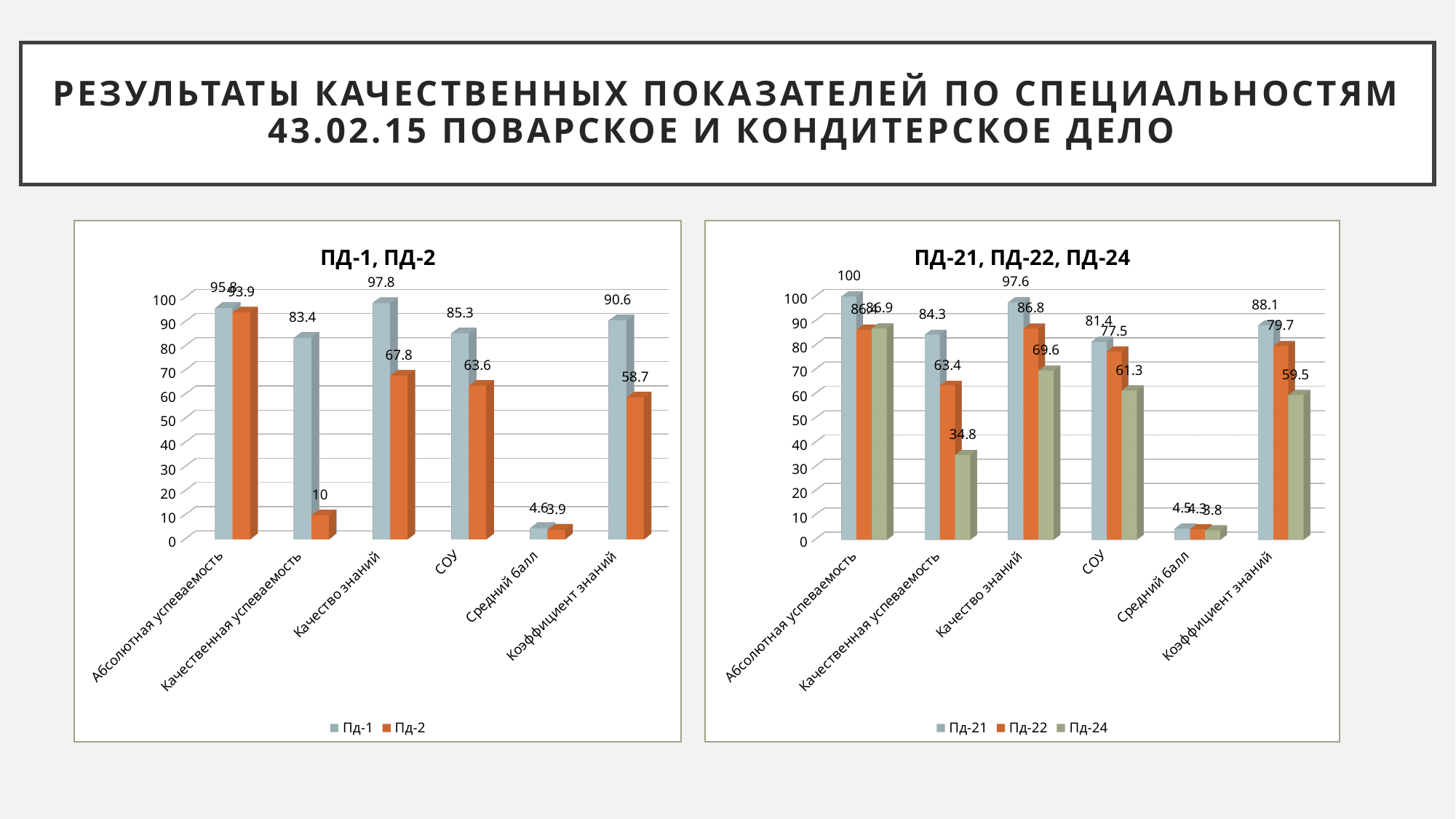
In the chart titled ПД-21, ПД-22, ПД-24, which is larger for Коэффициент знаний: Пд-22 or Пд-24? Пд-22 In the chart titled ПД-21, ПД-22, ПД-24, what is the value of Пд-22 for СОУ? 77.5 In the chart titled ПД-1, ПД-2, what is the value of Пд-2 for Качественная успеваемость? 10 In the chart titled ПД-1, ПД-2, what is the difference between Пд-1 and Пд-2 for Коэффициент знаний? 31.9 In the chart titled ПД-21, ПД-22, ПД-24, what is the value of Пд-24 for Качественная успеваемость? 34.8 In the chart titled ПД-21, ПД-22, ПД-24, what is the difference between Пд-21 and Пд-22 for Качество знаний? 10.8 In the chart titled ПД-1, ПД-2, which category has the highest Пд-1 value? Качество знаний How many categories are shown on the x axis of the chart titled ПД-21, ПД-22, ПД-24? 6 In the chart titled ПД-1, ПД-2, what is the value of Пд-1 for Качество знаний? 97.8 In the chart titled ПД-1, ПД-2, how many series does the legend list? 2 In the chart titled ПД-21, ПД-22, ПД-24, which category has the lowest Пд-21 value? Средний балл What type of chart is the chart titled ПД-1, ПД-2? Bar chart